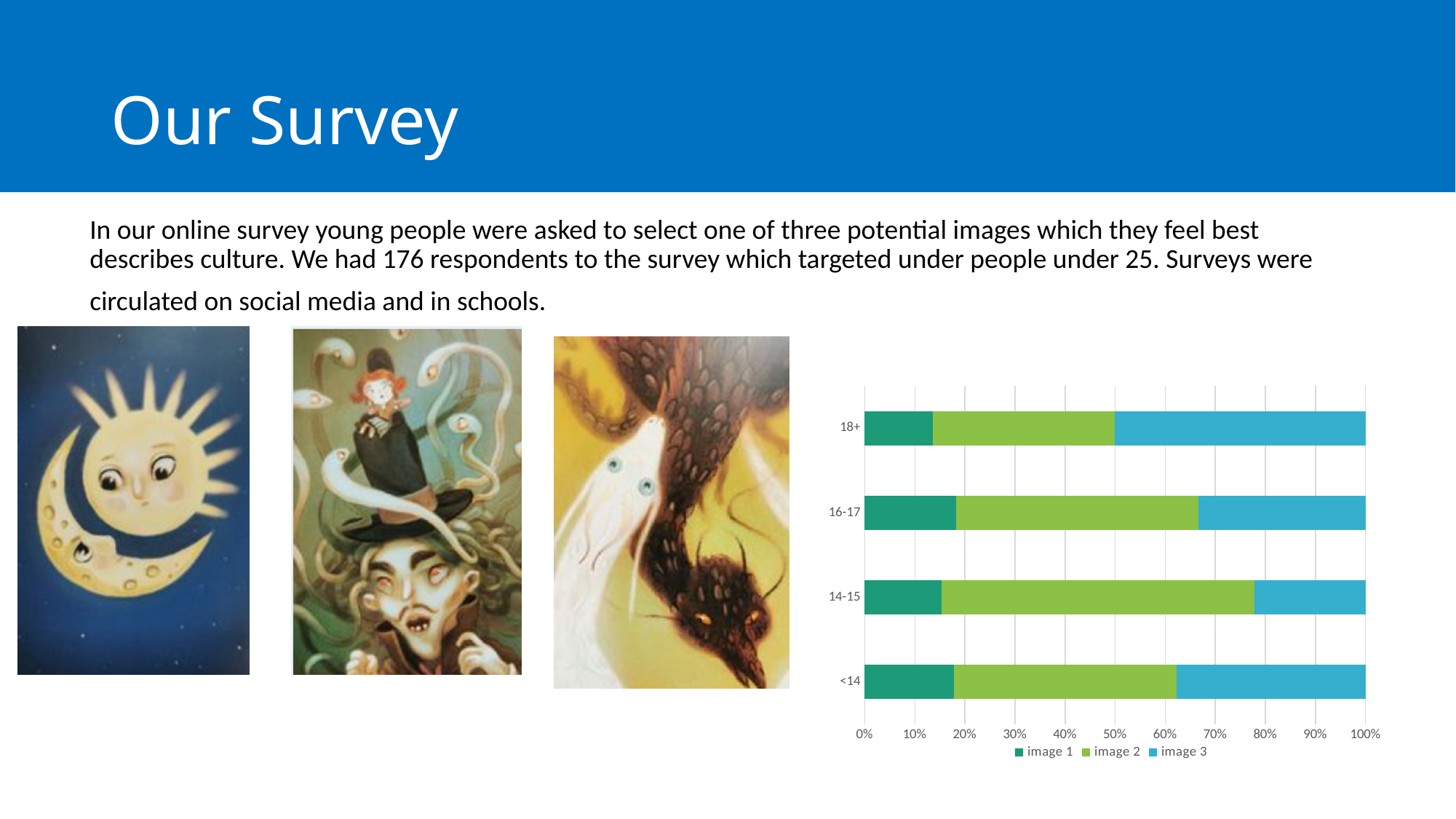
What are the series names listed in the chart legend? image 1, image 2, image 3 Is the value for image 3 in the 14-15 group greater or less than 30%? less Is the value for image 2 in the 14-15 group greater or less than 50%? greater How many series does the chart legend list? 3 Is the value for image 1 in the 18+ group greater or less than 20%? less Which age group has the largest share for image 3? 18+ Which age group is shown at the top of the chart? 18+ Which age group has the smallest share for image 3? 14-15 How many age-group categories does the chart show? 4 In the 18+ group, which is larger: the share for image 1 or the share for image 3? image 3 What kind of chart is shown on the slide? Stacked bar chart